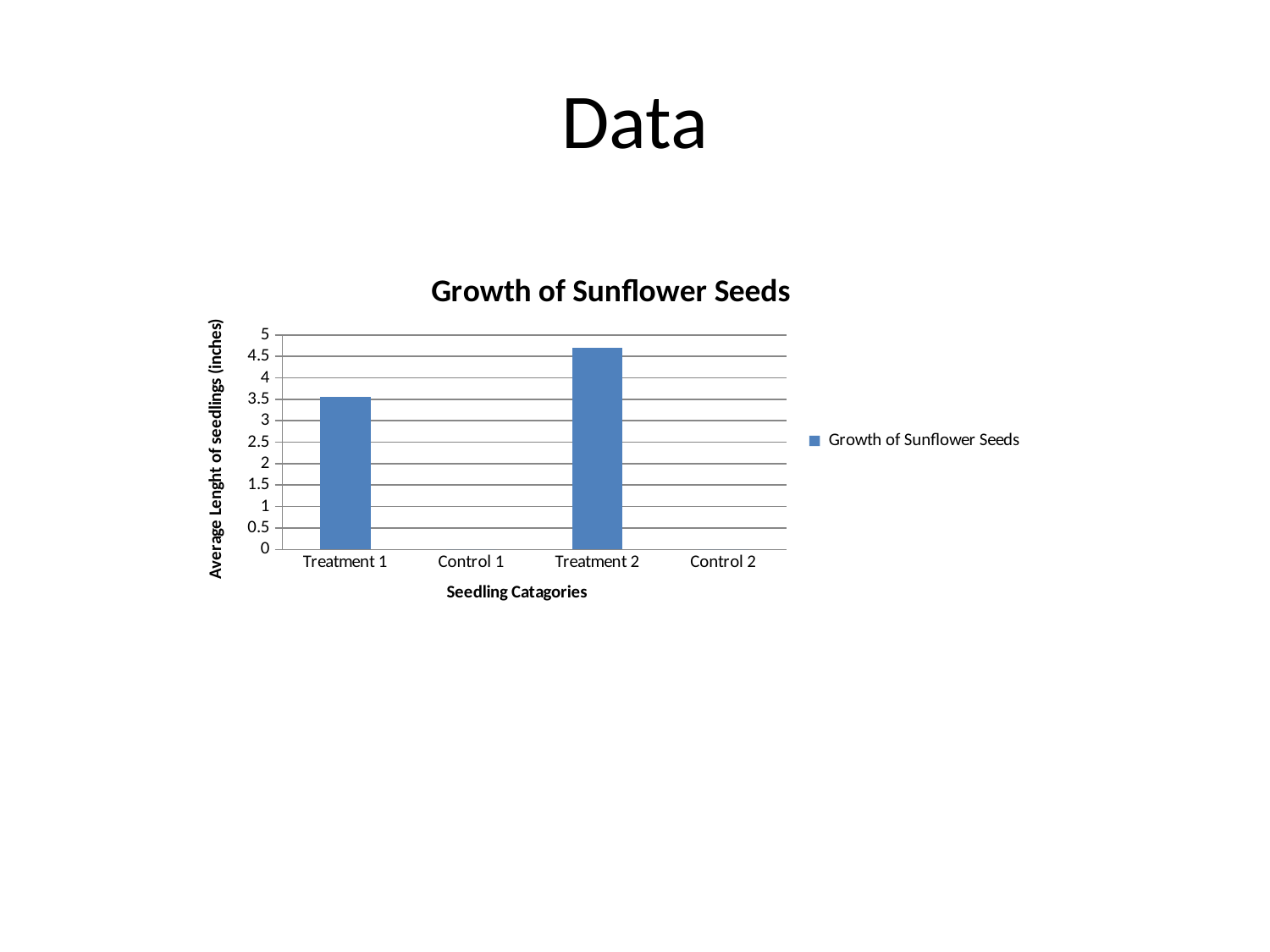
What kind of chart is shown on the slide? bar chart What is the title of the chart? Growth of Sunflower Seeds What is the label of the y axis of the chart? Average Lenght of seedlings (inches) Is the value for Treatment 2 greater or less than 5? less How many series does the legend list? 1 Is the value for Treatment 1 greater or less than 3? greater Which category has the highest value in the chart? Treatment 2 Is the value for Treatment 1 greater or less than 4? less Which is larger, the value for Treatment 1 or the value for Treatment 2? Treatment 2 How many categories are shown on the x axis of the chart? 4 Which is larger, the value for Control 1 or the value for Treatment 1? Treatment 1